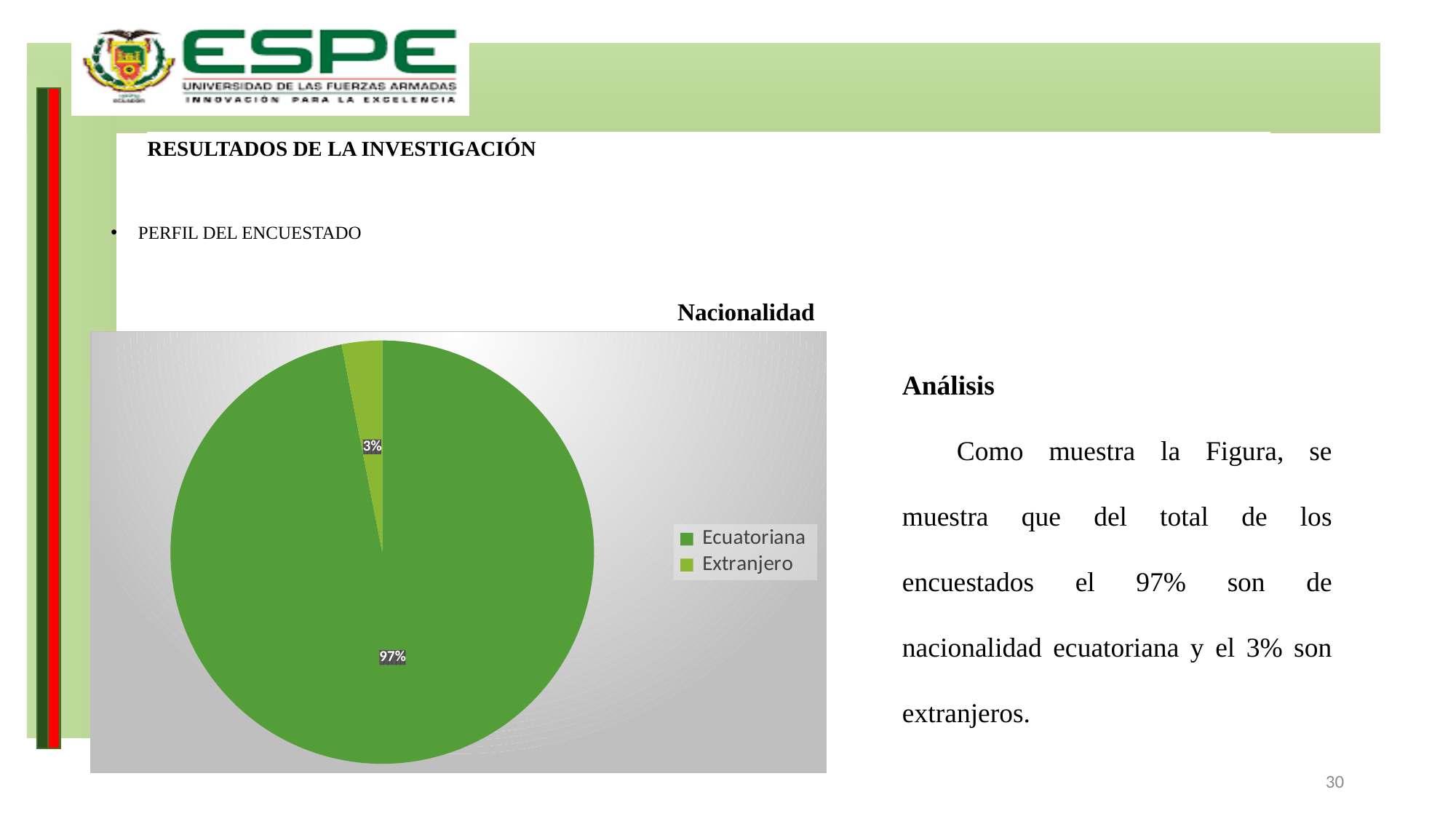
What kind of chart is shown on the slide? pie chart Which category has the largest share of the pie? Ecuatoriana What share of the pie does the Extranjero slice represent? 3% Which legend entry is shown in the lighter green colour? Extranjero What is the difference in percentage points between the Ecuatoriana and Extranjero slices? 94 How many entries does the legend list? 2 How many categories does the pie chart show? 2 What percentage of the pie is labelled Ecuatoriana? 97% Which slice is larger, Ecuatoriana or Extranjero? Ecuatoriana What is the title of the chart? Nacionalidad Which category has the smallest share of the pie? Extranjero What percentage of the pie is labelled Extranjero? 3%